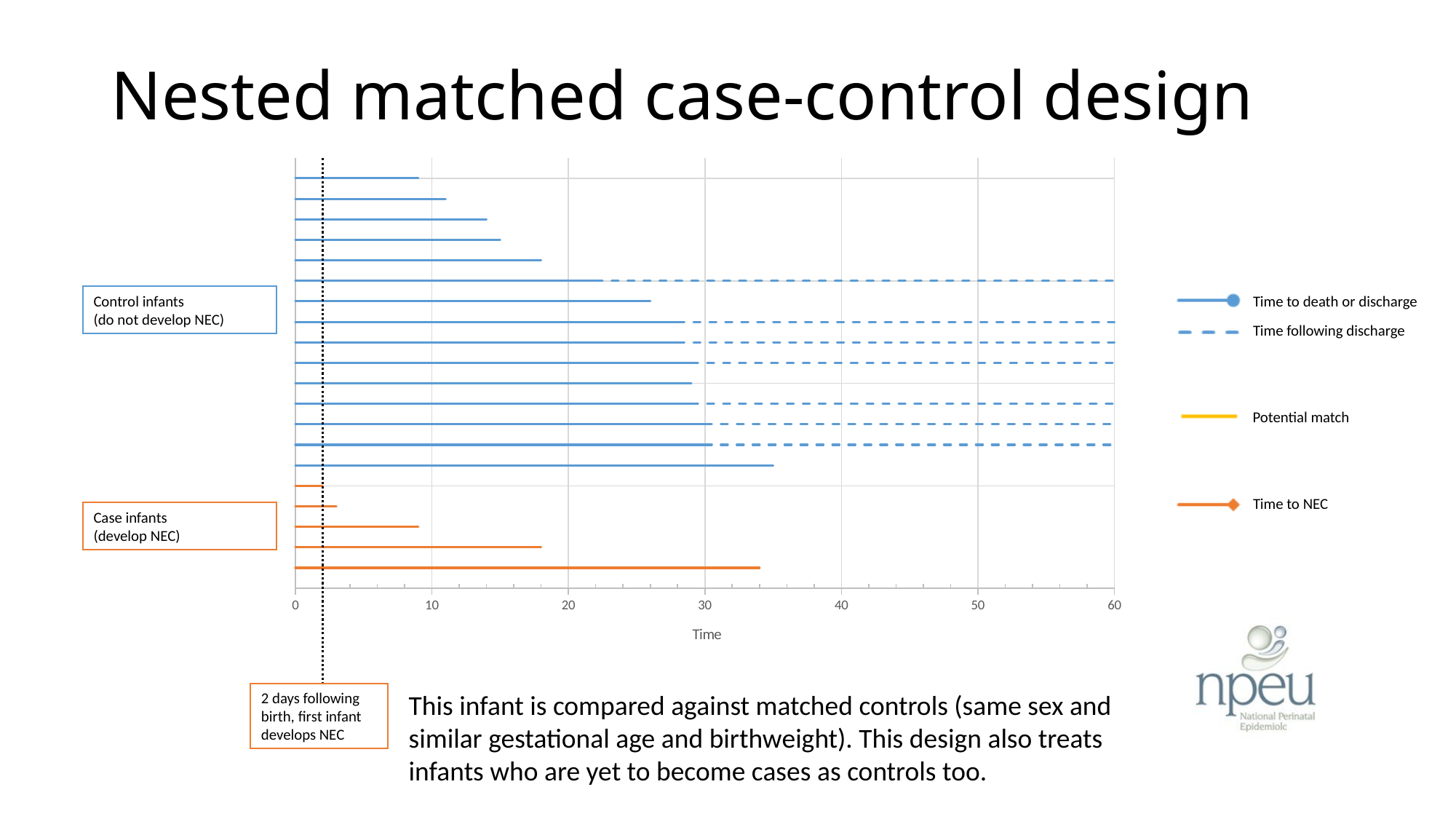
Is the time to NEC for the longest orange line greater or less than 30? greater How many entries does the chart legend list? 4 What is the label on the x axis of the chart? Time Which legend entry is drawn with a dashed line? Time following discharge Which is longer: the longest orange (Time to NEC) line or the shortest blue (Time to death or discharge) line? the longest orange line Is the time to death or discharge for the topmost control infant greater or less than 10? less What is the highest value shown on the x axis of the chart? 60 How many case infants (orange lines) are plotted on the chart? 5 How many control infants (blue lines) are plotted on the chart? 15 Is the time to NEC for the shortest orange line greater or less than 10? less What kind of chart is shown on the slide? line chart